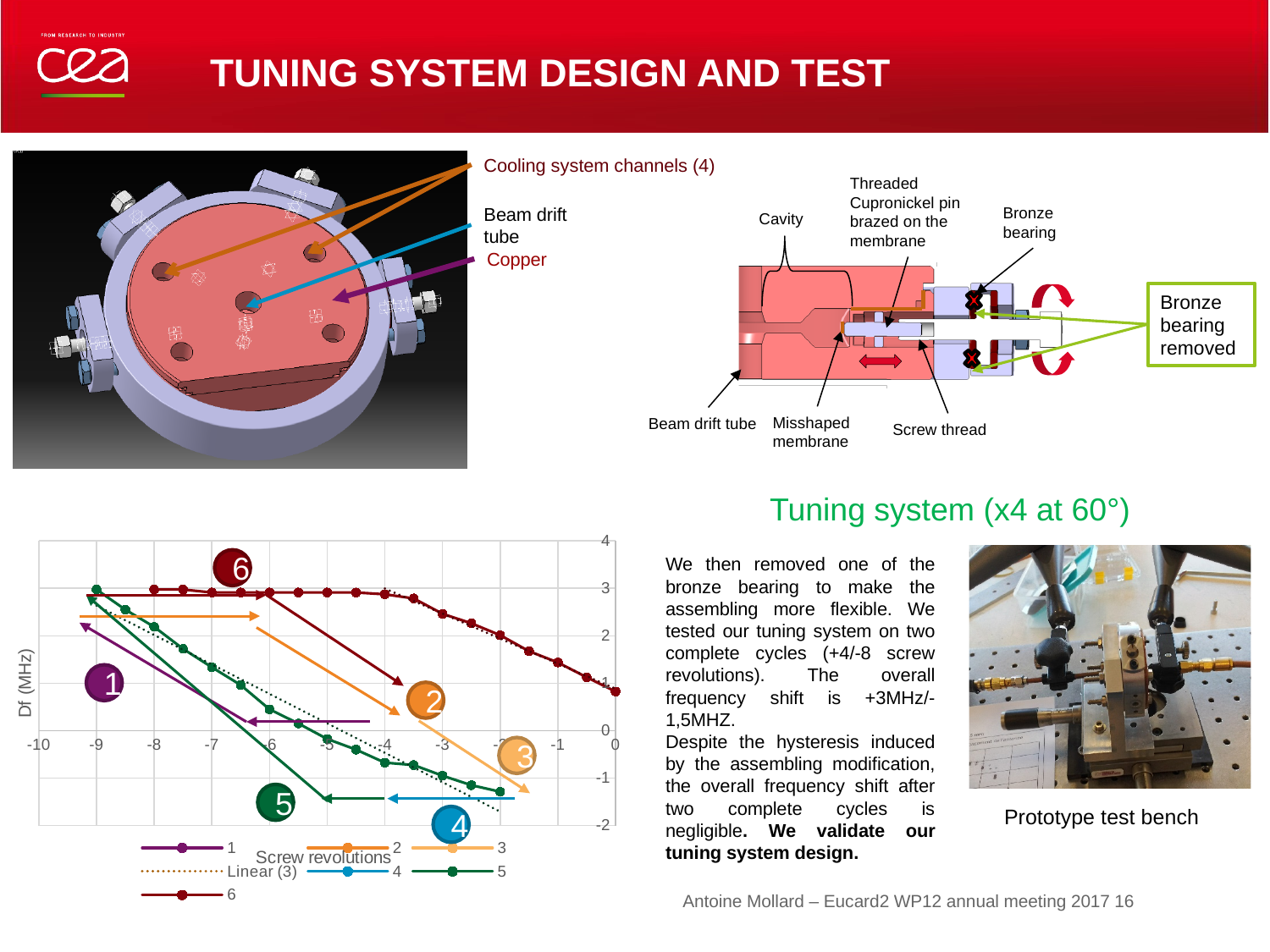
What is the title of the y axis of the line chart? Df (MHz) In the line chart, which is larger: the value of series 6 at -9 screw revolutions or at 0 screw revolutions? at -9 screw revolutions In the line chart, at which screw revolutions value does series 6 reach its lowest point? 0 In the line chart, is the value of series 6 at -9 screw revolutions greater or less than 2? greater How many entries does the legend of the line chart list? 7 In the line chart, does series 5 rise or fall as screw revolutions go from -9 to -5? fall What is the title of the x axis of the line chart? Screw revolutions In the line chart, is the value of series 5 at -5 screw revolutions greater or less than 0? less What kind of chart is shown at the bottom left of the slide? line chart In the line chart, does series 6 rise or fall as screw revolutions go from -9 to 0? fall In the line chart, is the value of series 6 at 0 screw revolutions greater or less than 2? less